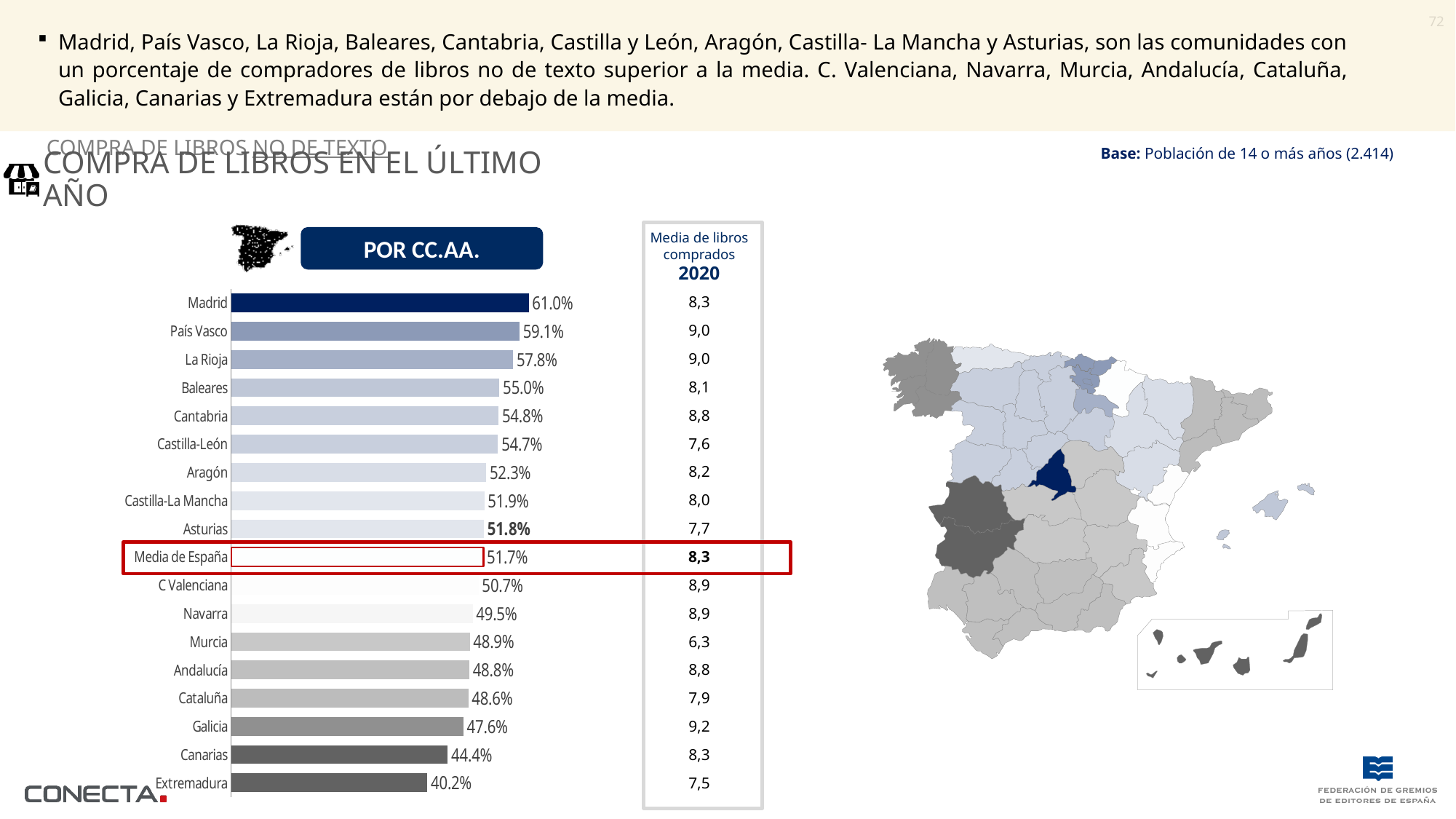
In the 'POR CC.AA.' chart, what is the difference between the values for Madrid and Extremadura? 20.8 percentage points What type of chart is shown under the heading 'POR CC.AA.'? Bar chart In the 'POR CC.AA.' chart, what is the value for Madrid? 61.0% In the 'Media de libros comprados 2020' column, what is the value for Galicia? 9,2 In the 'POR CC.AA.' chart, do the values rise or fall going from the top bar to the bottom bar? Fall In the 'POR CC.AA.' chart, which community has the highest value? Madrid In the 'Media de libros comprados 2020' column, which community has the lowest value? Murcia In the 'POR CC.AA.' chart, which community has the lowest value? Extremadura How many bars are shown in the 'POR CC.AA.' chart, including Media de España? 18 In the 'POR CC.AA.' chart, which has a larger value, Baleares or Cataluña? Baleares In the 'POR CC.AA.' chart, what is the value for Media de España? 51.7% In the 'POR CC.AA.' chart, what is the value for Galicia? 47.6%